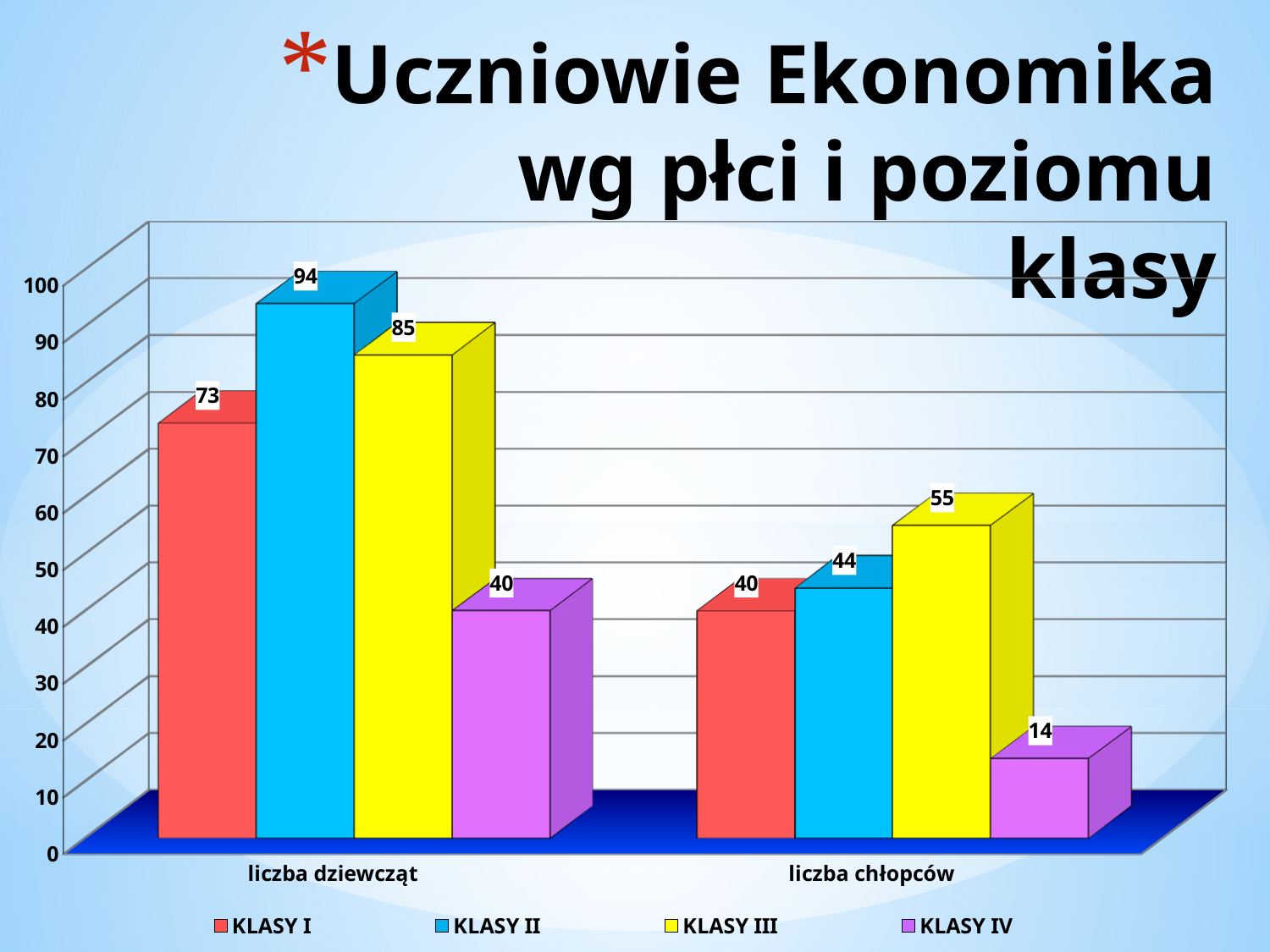
How many categories are shown on the x axis? 2 How many series does the legend list? 4 What colour represents KLASY IV in the chart? purple What kind of chart is shown on the slide? bar chart What is the value for KLASY IV in the liczba chłopców category? 14 Is the value for KLASY III in the liczba dziewcząt category greater or less than 80? greater What is the difference between the KLASY III values for liczba dziewcząt and liczba chłopców? 30 Which series has the lowest value in the liczba chłopców category? KLASY IV What is the value for KLASY I in the liczba chłopców category? 40 What is the value for KLASY II in the liczba dziewcząt category? 94 Which series has the highest value in the liczba dziewcząt category? KLASY II Which is larger: KLASY I for liczba dziewcząt or KLASY III for liczba chłopców? KLASY I for liczba dziewcząt